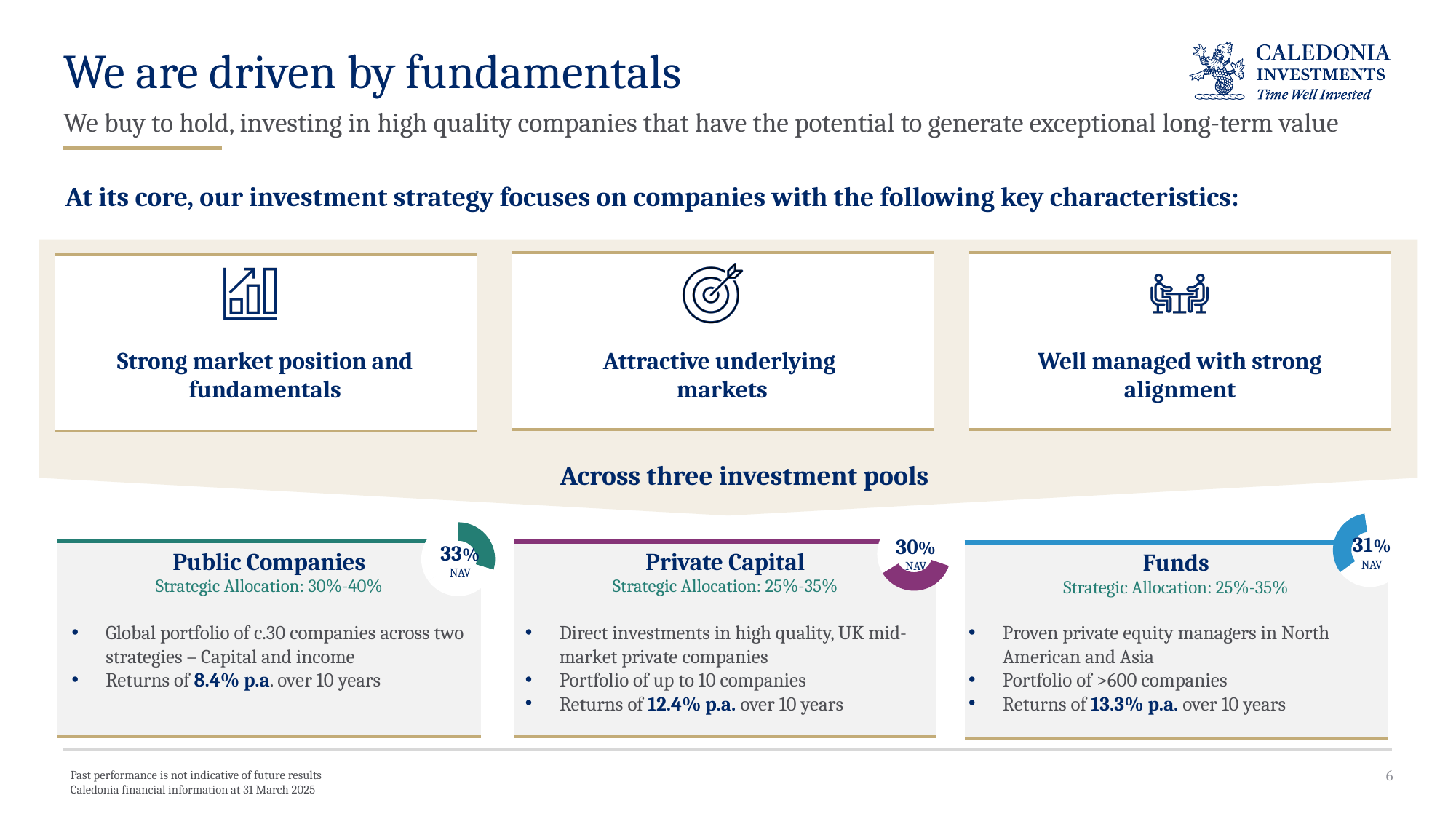
Which investment pool has the highest NAV share shown? Public Companies Which investment pool has the lowest NAV share shown? Private Capital Which has a larger NAV share, Public Companies or Funds? Public Companies What is the total NAV share across the three investment pools shown? 94% How many investment pools have a NAV share chart on the slide? 3 What share of NAV is shown for the Private Capital pool? 30% What colour is the NAV share chart for the Private Capital pool? Purple What is the difference between the NAV share of Public Companies and Private Capital? 3% What is the difference between the NAV share of Funds and Private Capital? 1% What share of NAV is shown for the Funds pool? 31% What kind of chart is used to show the NAV share for each investment pool? Doughnut chart What share of NAV is shown for the Public Companies pool? 33%